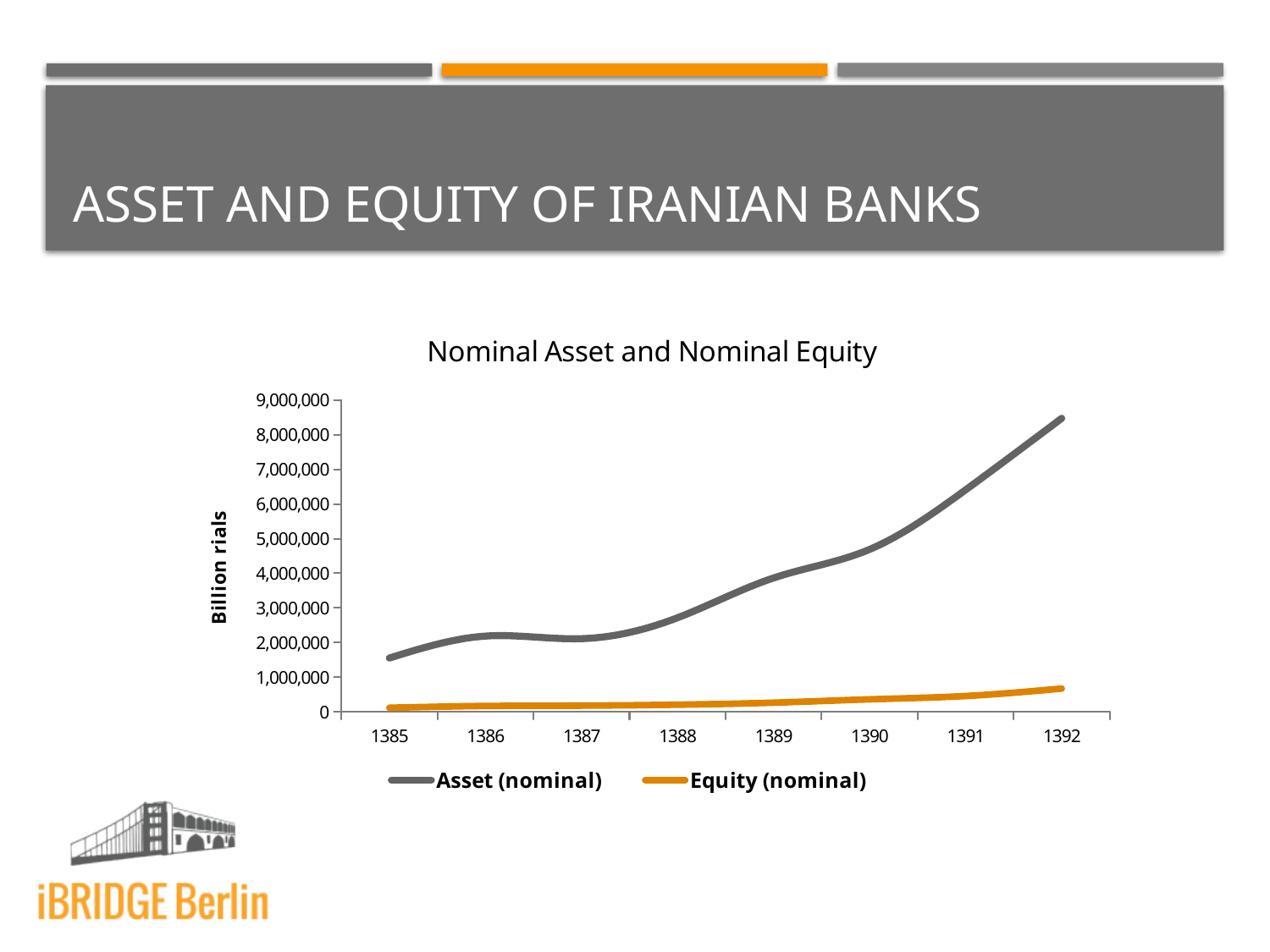
What is the title of the chart? Nominal Asset and Nominal Equity Does the Asset (nominal) line generally rise or fall from 1385 to 1392? rise In 1392, which is larger: Asset (nominal) or Equity (nominal)? Asset (nominal) How many series does the legend list? 2 In which year is Asset (nominal) highest? 1392 What is the label on the vertical axis? Billion rials How many years are plotted along the x axis? 8 Is the value for Asset (nominal) in 1390 greater or less than 5,000,000? less Is the value for Asset (nominal) in 1392 greater or less than 8,000,000? greater In which year is Asset (nominal) lowest? 1385 What kind of chart is shown on the slide? line chart Is the value for Equity (nominal) in 1392 greater or less than 1,000,000? less